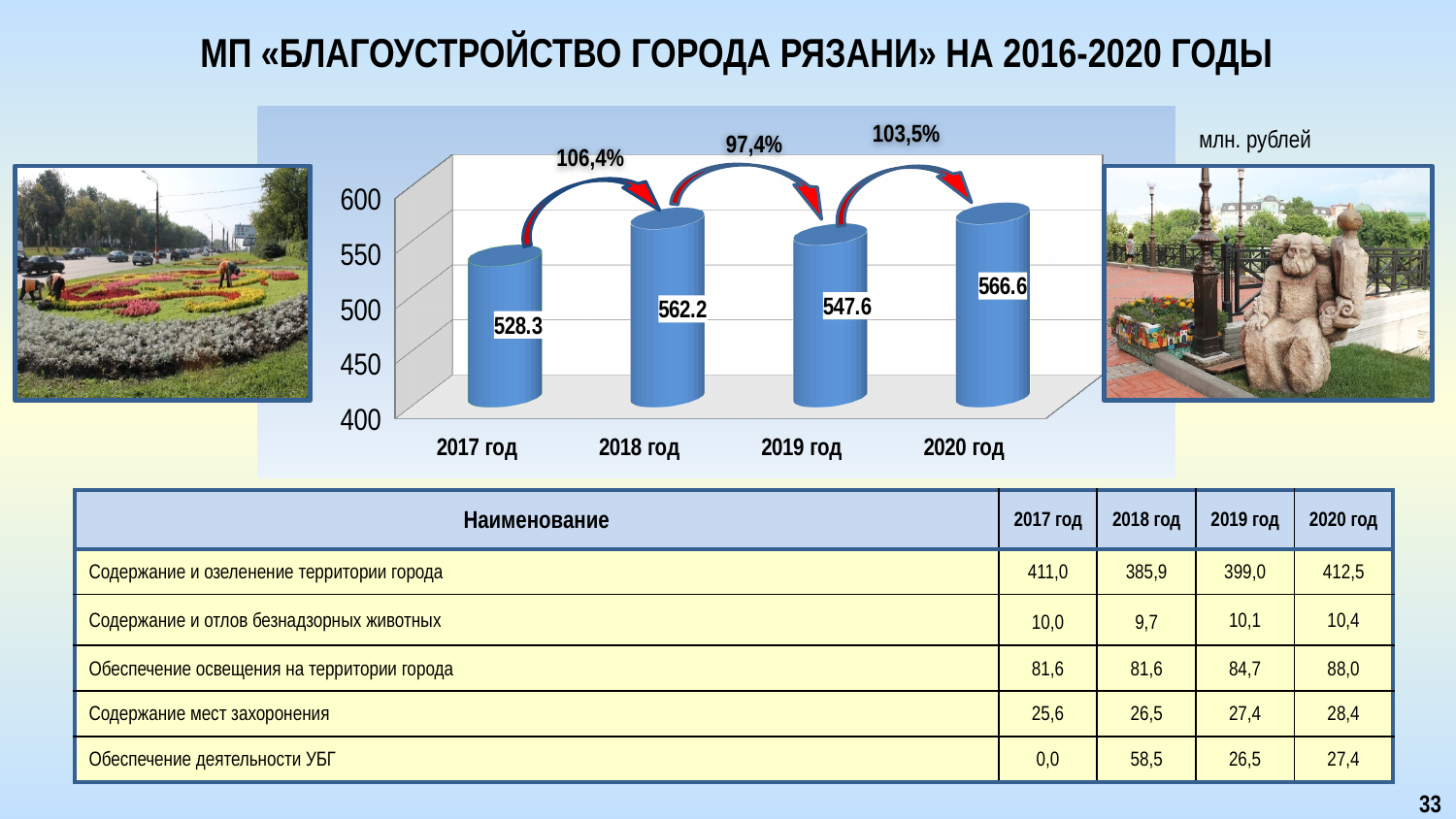
What is the value for 2019 год? 547.6 What is the value for 2018 год? 562.2 Which year has the highest value? 2020 год Is the value for 2017 год greater or less than 550? less What is the value for 2020 год? 566.6 What is the difference between the values for 2018 год and 2017 год? 33.9 How many years are shown on the x axis of the chart? 4 What unit is indicated for the chart values? млн. рублей What is the value for 2017 год? 528.3 Which is larger, the value for 2018 год or 2019 год? 2018 год What kind of chart is shown on the slide? bar chart Which year has the lowest value? 2017 год